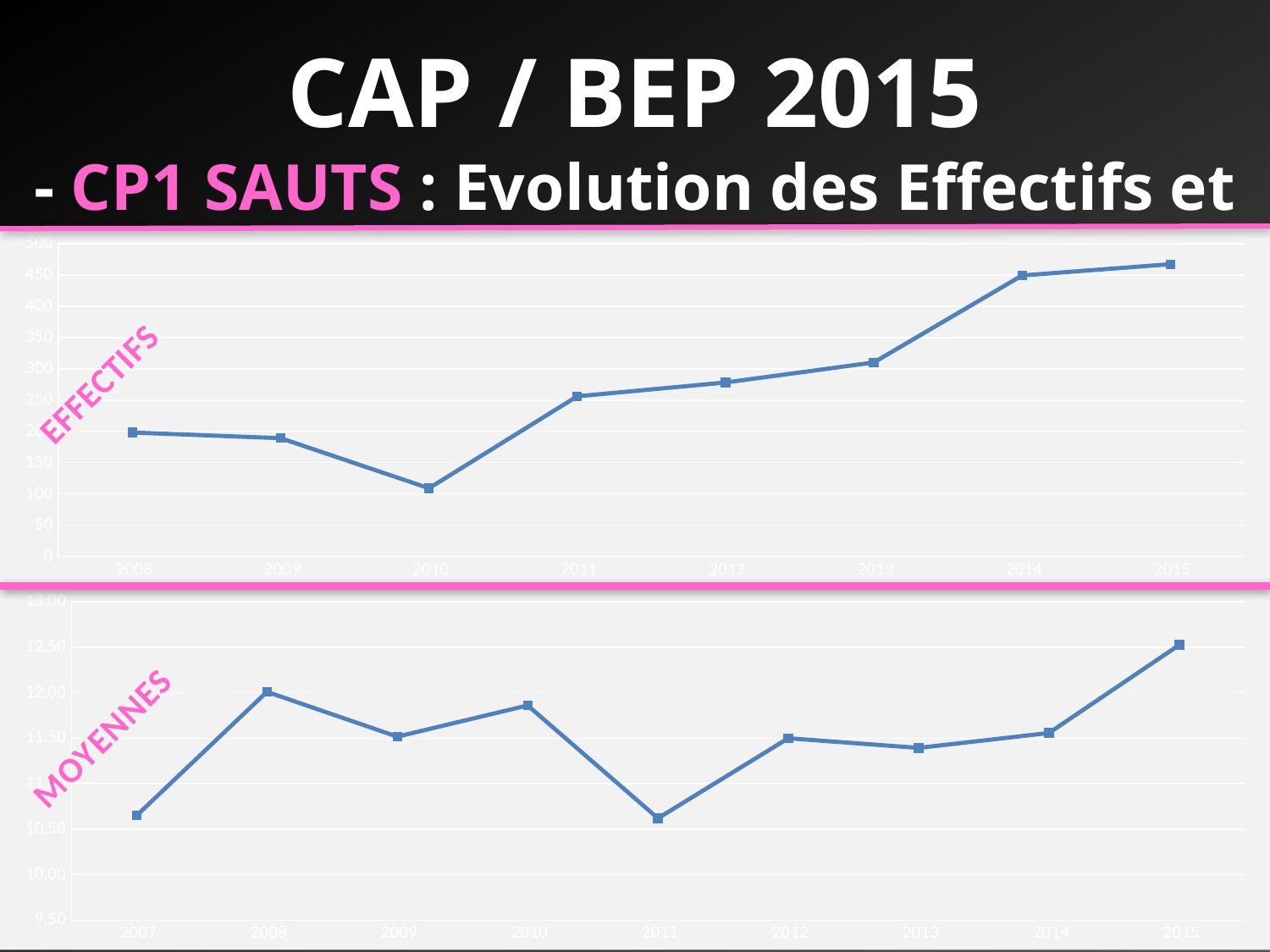
What kind of chart is the EFFECTIFS chart at the top of the slide? line chart In the EFFECTIFS chart, which year has the lowest value? 2010 How many years are plotted on the x axis of the MOYENNES chart? 9 In the EFFECTIFS chart, is the value for 2014 greater or less than 400? greater How many years are plotted on the x axis of the EFFECTIFS chart? 8 In the EFFECTIFS chart, which year has the larger value, 2011 or 2013? 2013 In the EFFECTIFS chart, do the values rise or fall from 2010 to 2015? rise In the EFFECTIFS chart, which year has the highest value? 2015 In the MOYENNES chart, which year has the highest value? 2015 In the MOYENNES chart, is the value for 2011 greater or less than 11.00? less In the MOYENNES chart, which year has the larger value, 2008 or 2009? 2008 In the EFFECTIFS chart, is the value for 2010 greater or less than 150? less